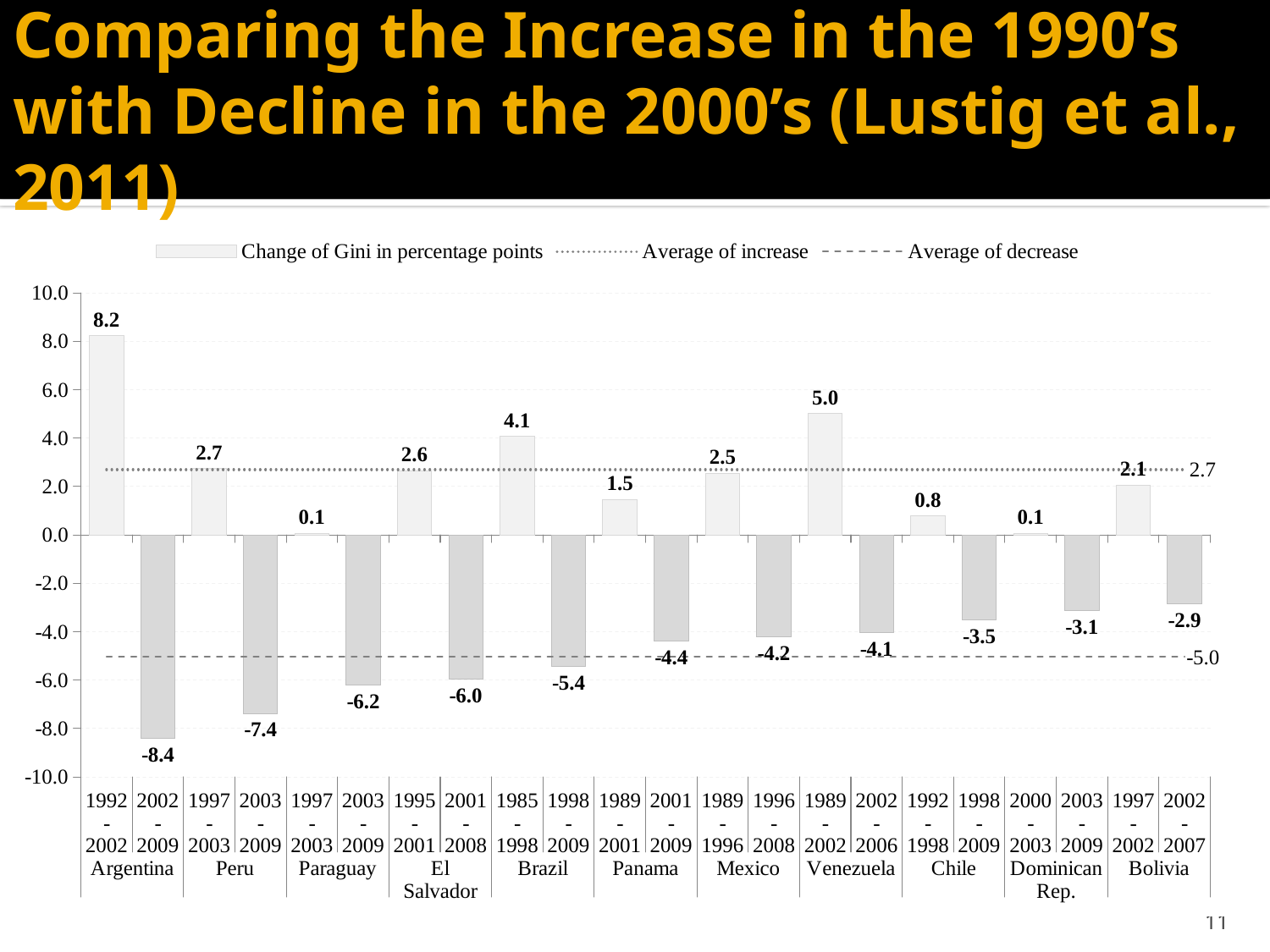
What is the change of Gini in percentage points for Brazil in 1998-2009? -5.4 Which country-period has the highest change of Gini in percentage points? Argentina 1992-2002 How many countries are shown on the x axis of the chart? 11 What is the difference between the change of Gini for Peru in 1997-2003 and Peru in 2003-2009? 10.1 How many entries does the legend list? 3 What value does the 'Average of decrease' line mark? -5.0 What is the change of Gini in percentage points for Venezuela in 1989-2002? 5.0 Which is larger, the change of Gini for Brazil in 1985-1998 or for Mexico in 1989-1996? Brazil 1985-1998 What is the change of Gini in percentage points for Argentina in 1992-2002? 8.2 What value does the 'Average of increase' line mark? 2.7 What kind of chart is shown on the slide? Combination bar and line chart (bars with two average lines) Which country-period has the lowest change of Gini in percentage points? Argentina 2002-2009